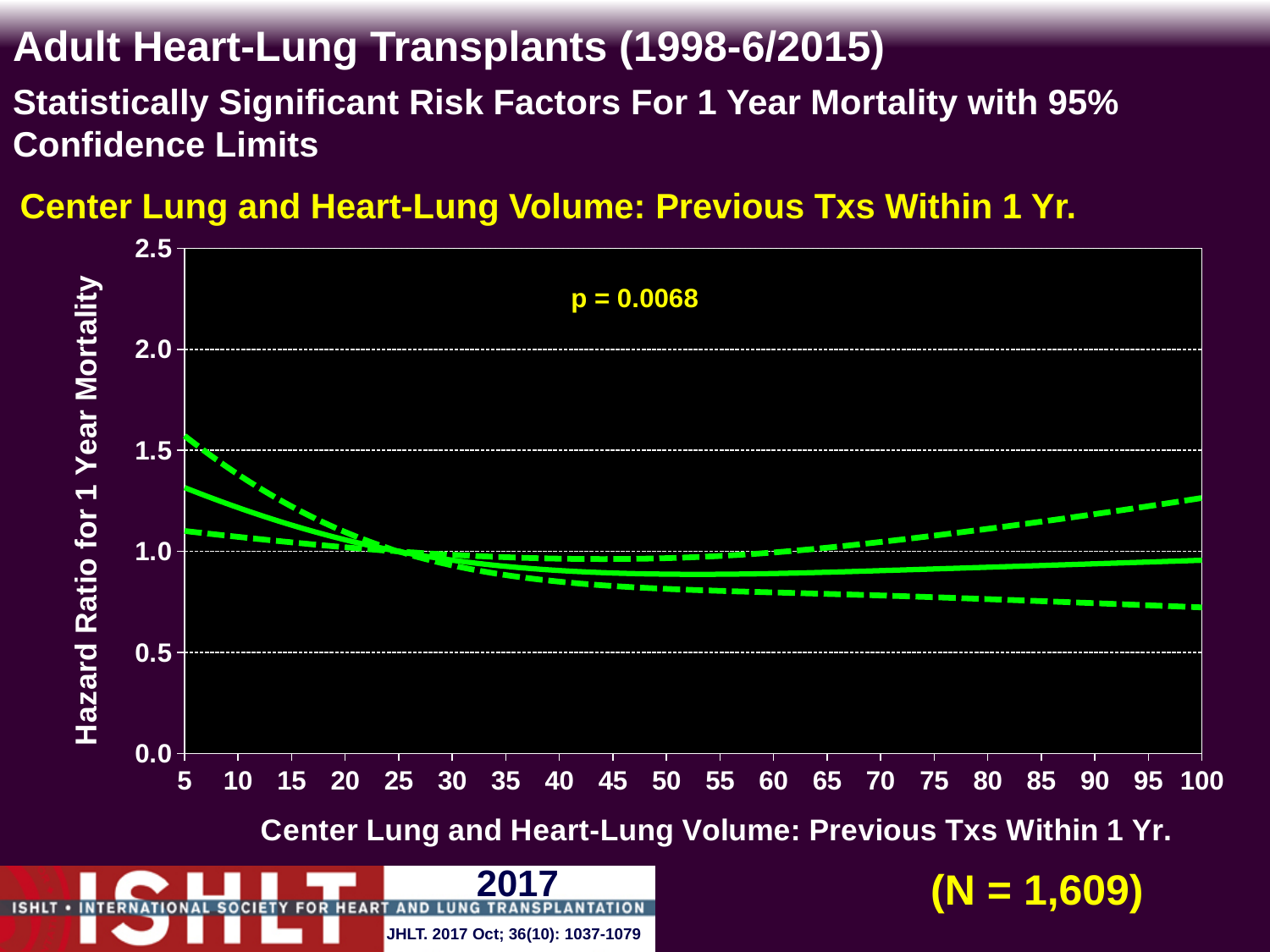
What is the sample size (N) shown on the slide? 1,609 What is the label of the y axis? Hazard Ratio for 1 Year Mortality How many tick marks are labeled on the x axis? 20 Is the lower confidence limit (lower dashed line) at a center volume of 100 greater or less than 1.0? less Is the hazard ratio (solid line) at a center volume of 5 greater or less than 1.0? greater What is the label of the x axis? Center Lung and Heart-Lung Volume: Previous Txs Within 1 Yr. What is the highest value labeled on the y axis? 2.5 What kind of chart is shown on the slide? line chart Is the hazard ratio (solid line) at a center volume of 50 greater or less than 1.0? less What p-value is printed on the chart? p = 0.0068 Does the hazard ratio (solid line) rise or fall as center volume increases from 5 to 50? fall